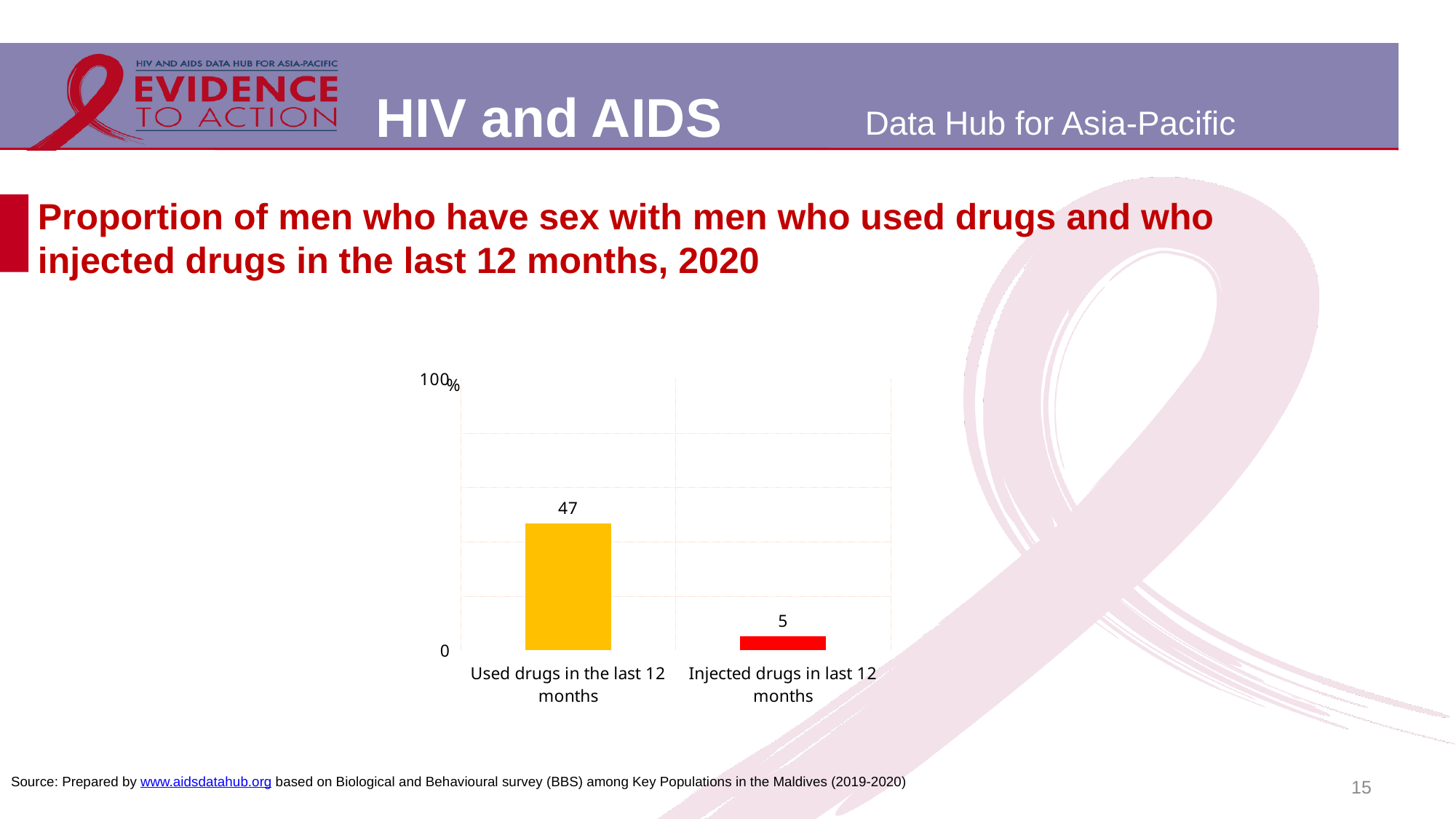
Is the value for 'Used drugs in the last 12 months' greater or less than 100? less What is the maximum value shown on the y axis? 100 What is the difference between the value for 'Used drugs in the last 12 months' and 'Injected drugs in last 12 months'? 42 What kind of chart is shown on the slide? bar chart What is the value for 'Injected drugs in last 12 months'? 5 Which category has the lowest value? Injected drugs in last 12 months How many categories are shown in the chart? 2 Which category has the highest value? Used drugs in the last 12 months What colour is the bar for 'Injected drugs in last 12 months'? red Which is larger: the value for 'Used drugs in the last 12 months' or 'Injected drugs in last 12 months'? Used drugs in the last 12 months What is the value for 'Used drugs in the last 12 months'? 47